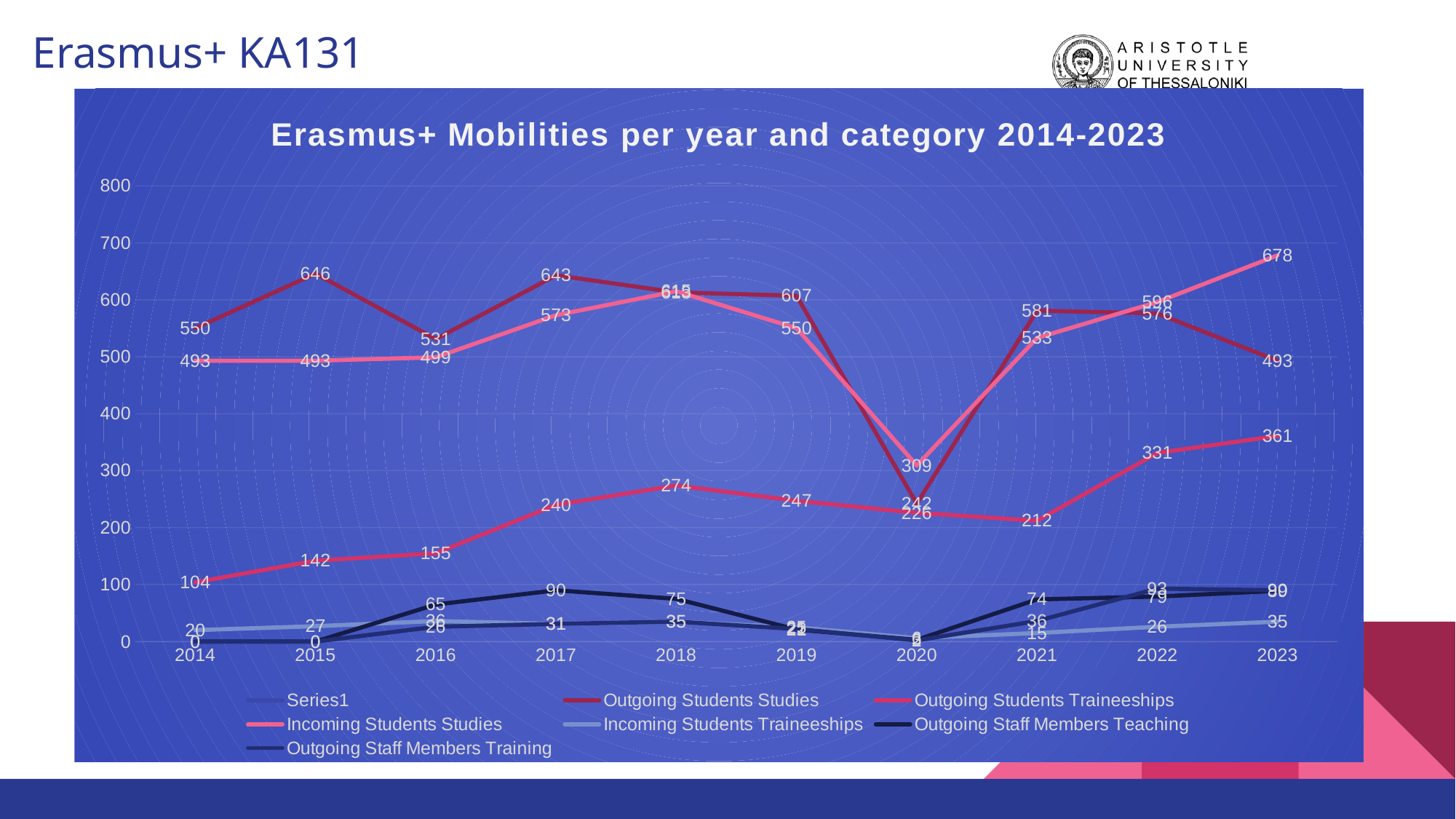
What is the difference between the Outgoing Students Studies values in 2015 and 2020? 404 In which year is Incoming Students Studies lowest? 2020 What is the value for Incoming Students Studies in 2023? 678 In which year is Outgoing Students Studies highest? 2015 How many years are shown on the x axis? 10 What is the value for Outgoing Students Studies in 2015? 646 What is the value for Outgoing Staff Members Teaching in 2017? 90 What is the value for Outgoing Students Traineeships in 2018? 274 In 2017, which is larger: Outgoing Students Studies or Incoming Students Studies? Outgoing Students Studies How many series does the legend list? 7 Does Outgoing Students Traineeships rise or fall from 2014 to 2017? Rise What kind of chart is shown on the slide? Line chart